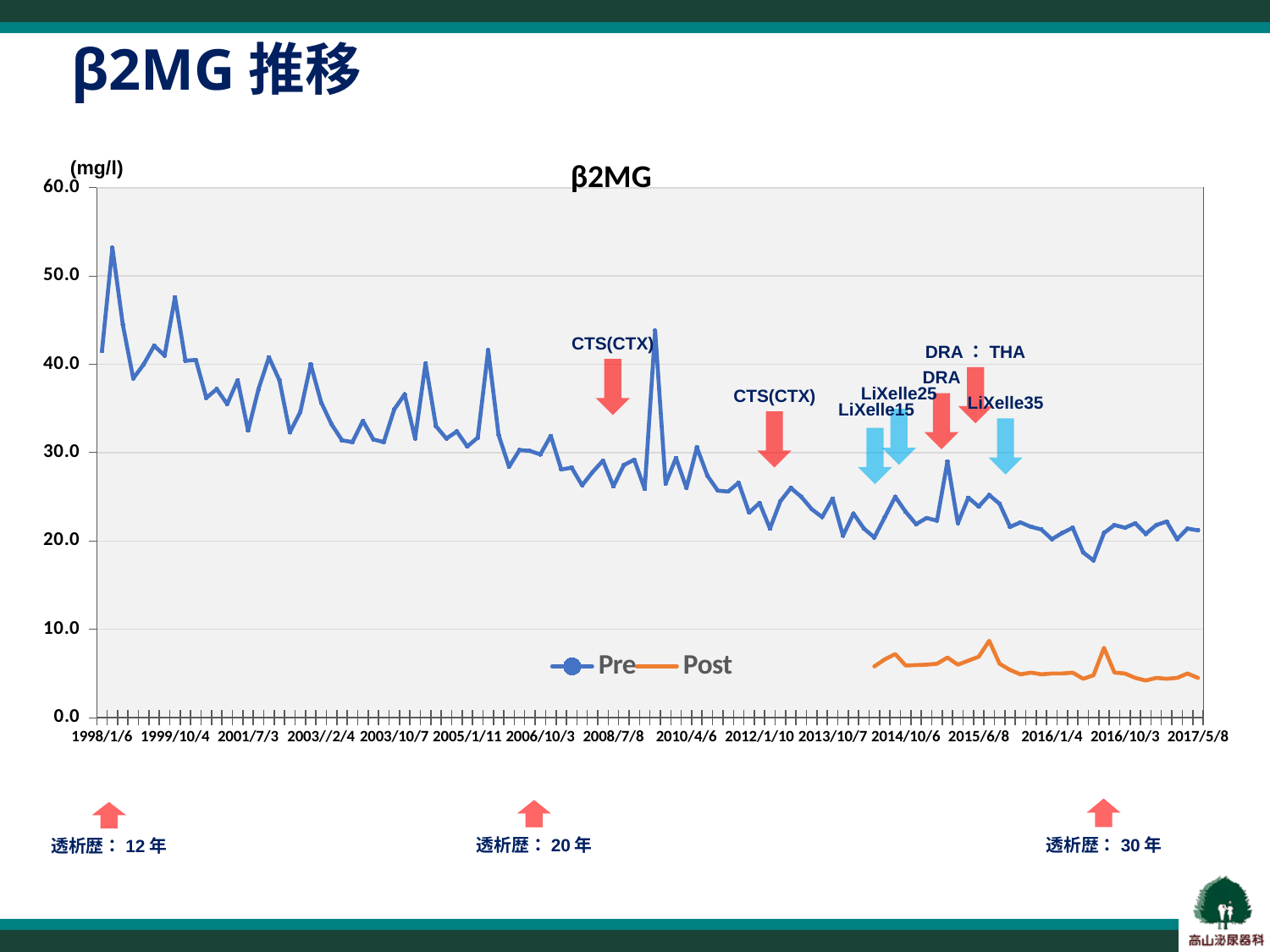
What are the names of the two series in the legend of the β2MG chart? Pre and Post What unit is shown on the y axis of the β2MG chart? mg/l Which series, Pre or Post, stays below 10.0 for its entire plotted range? Post Does the Pre series generally rise or fall from 1998/1/6 to 2017/5/8? fall At 2017/5/8, which series has the larger value, Pre or Post? Pre Is the highest Pre value on the chart greater or less than 50.0? greater What kind of chart is shown on the slide? line chart Is the Post value at 2017/5/8 greater or less than 10.0? less What is the maximum value shown on the y axis of the β2MG chart? 60.0 Is the Pre value at 1998/1/6 greater or less than 30.0? greater How many series does the legend of the β2MG chart list? 2